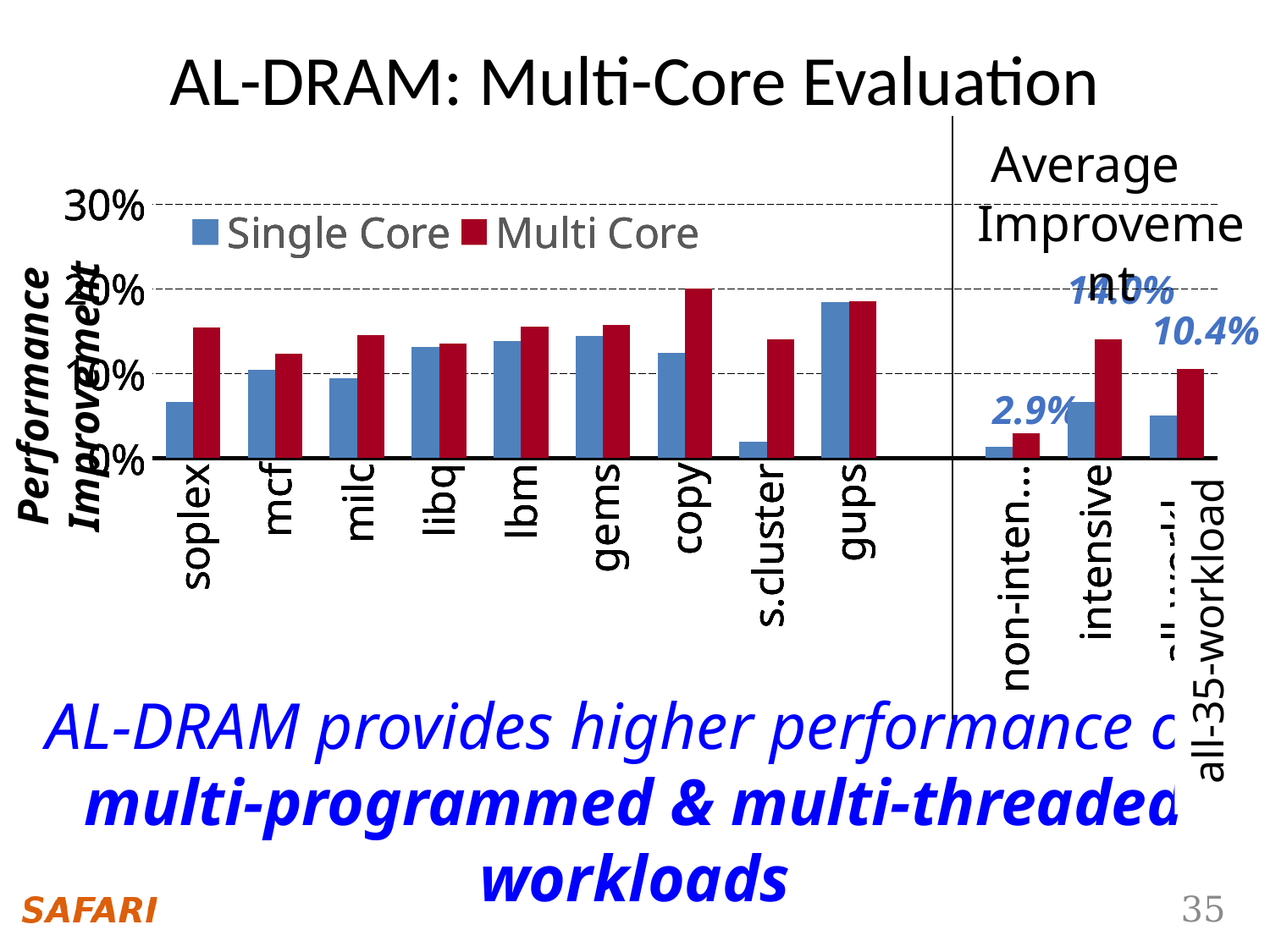
What kind of chart is shown on the slide? bar chart What are the two series named in the legend? Single Core and Multi Core How many series does the legend list? 2 What value is labelled above the all-35-workload bars? 10.4% Which category has the highest Single Core value? gups What value is labelled above the non-intensive bars? 2.9% Is the Multi Core value for gups greater or less than 10%? greater What is the title of the slide's chart? AL-DRAM: Multi-Core Evaluation Which category has the highest Multi Core value? copy For soplex, which is larger: the Single Core value or the Multi Core value? Multi Core Is the Single Core value for s.cluster greater or less than 10%? less What value is labelled above the intensive bars? 14.0%